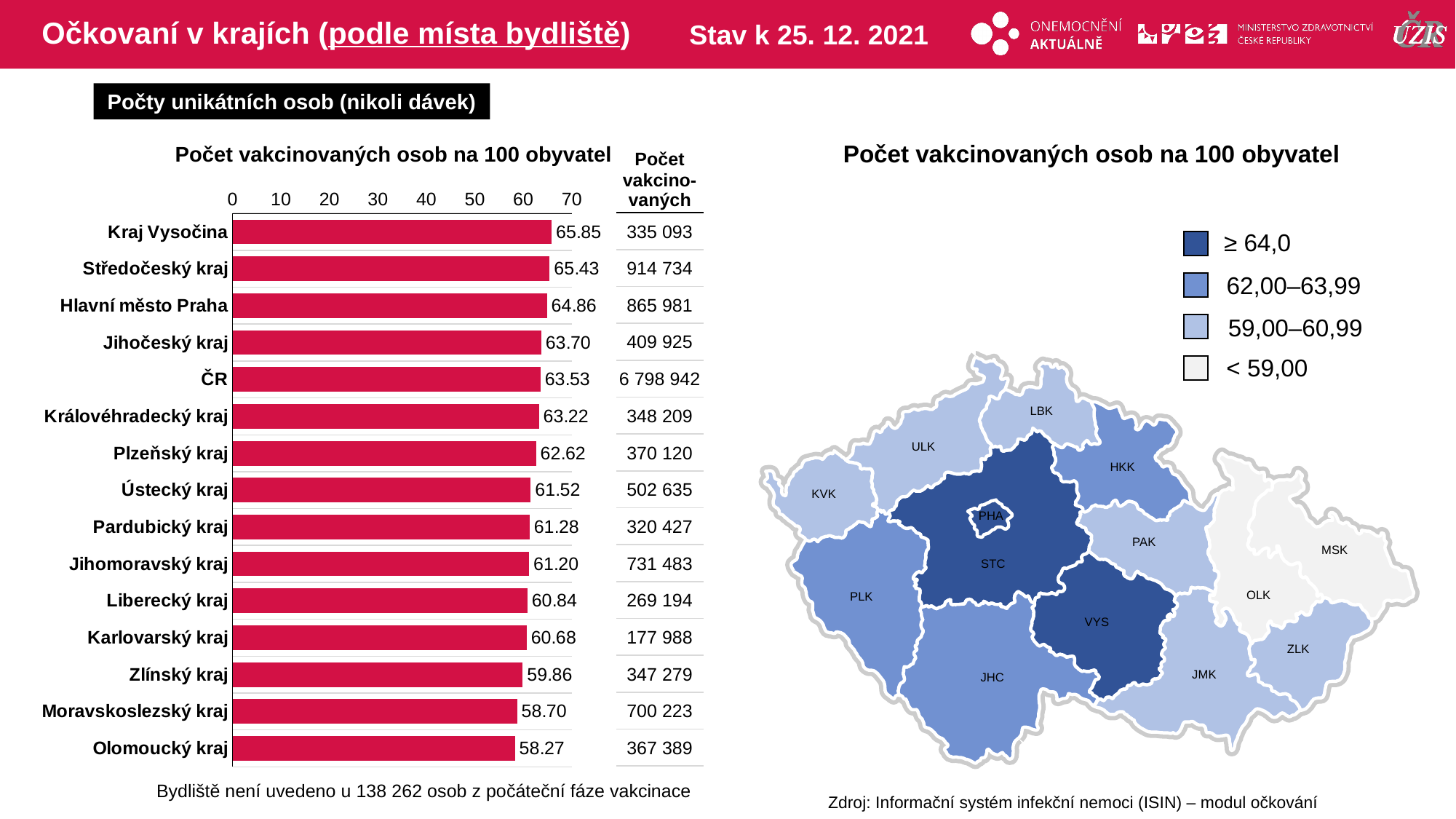
How many bars (categories) are shown in the bar chart? 15 In the bar chart, which has the larger value: Plzeňský kraj or Ústecký kraj? Plzeňský kraj Which region has the lowest value in the bar chart? Olomoucký kraj What is the difference between the values for Kraj Vysočina and Olomoucký kraj in the bar chart? 7.58 In the bar chart, what is the value for Kraj Vysočina? 65.85 What is the difference between the values for Středočeský kraj and Hlavní město Praha in the bar chart? 0.57 What kind of chart is shown on the left of the slide? bar chart Which region has the highest value in the bar chart? Kraj Vysočina In the bar chart, is the value for Moravskoslezský kraj greater or less than 60? less Do the bar values increase or decrease from the top of the chart to the bottom? decrease In the bar chart, what is the value for ČR? 63.53 What is the title of the bar chart on the left? Počet vakcinovaných osob na 100 obyvatel